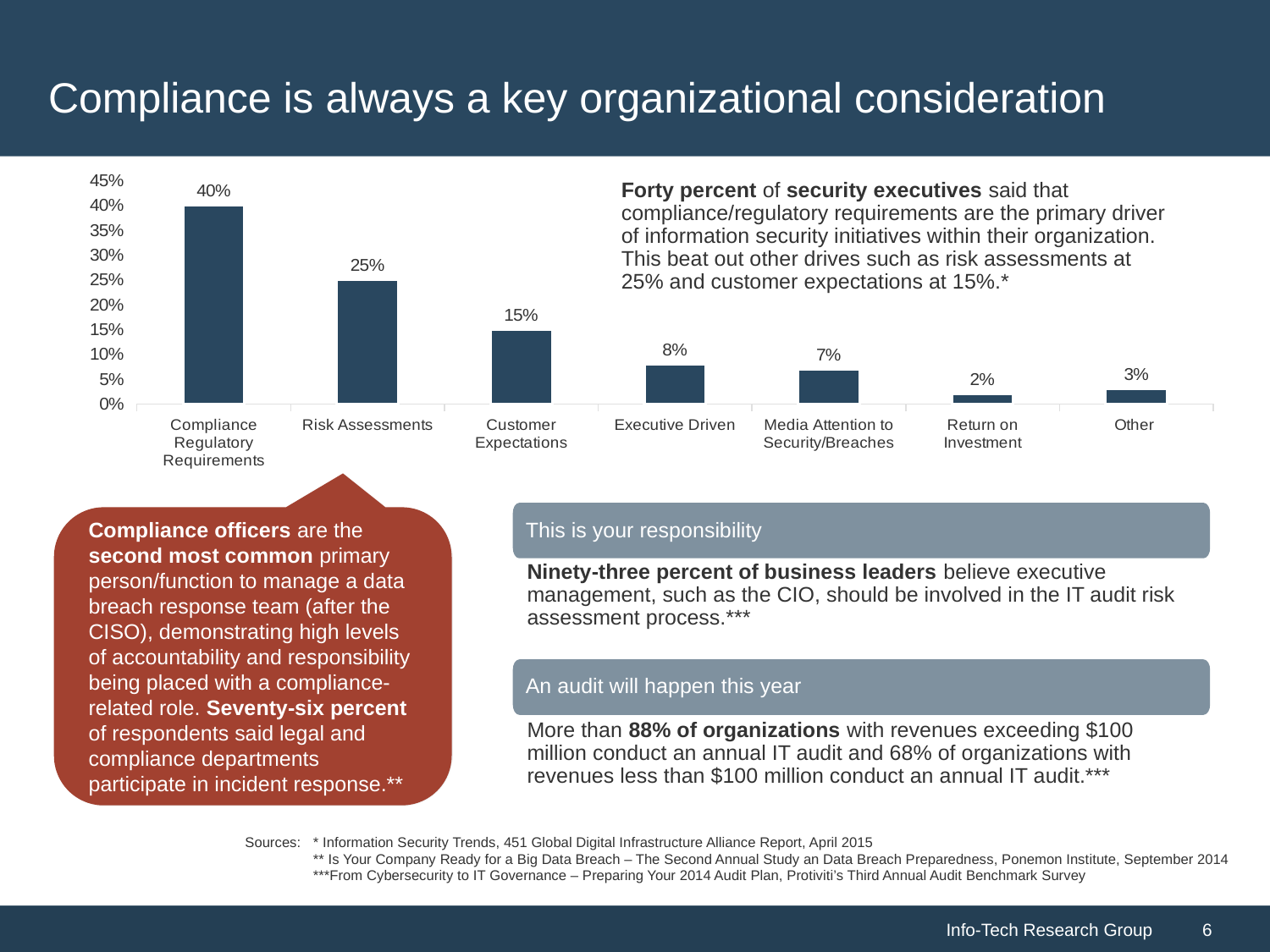
What is the value for Return on Investment? 2% What is the difference between Risk Assessments and Customer Expectations? 10% What is the value for Media Attention to Security/Breaches? 7% What kind of chart is shown on the slide? bar chart What is the value for Compliance Regulatory Requirements? 40% What is the highest value shown on the vertical axis? 45% Which category has the lowest value? Return on Investment What is the difference between Compliance Regulatory Requirements and Executive Driven? 32% Is the value for Customer Expectations greater or less than 20%? less How many categories are shown on the chart? 7 Which is larger, Executive Driven or Other? Executive Driven Which category has the highest value? Compliance Regulatory Requirements